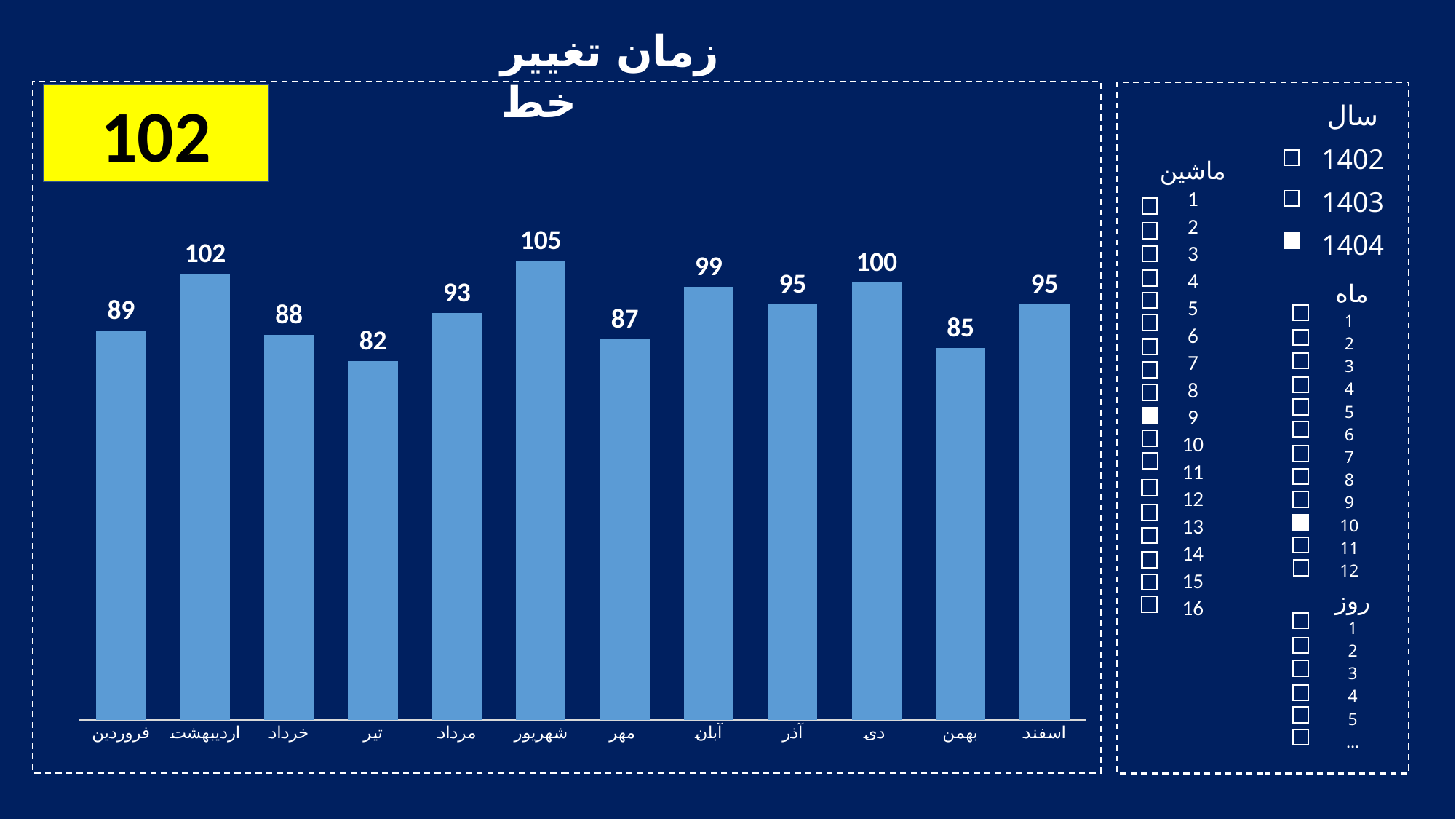
Which is larger, the value for آبان or the value for مهر? آبان What is the title of the chart? زمان تغییر خط What kind of chart is shown on the slide? bar chart What is the difference between the values for شهریور and تیر? 23 What is the value for شهریور? 105 How many months are shown on the x axis? 12 What is the value for دی? 100 What is the value for اردیبهشت? 102 Which month has the lowest value? تیر What is the difference between the values for اردیبهشت and فروردین? 13 What is the value for تیر? 82 Which month has the highest value? شهریور